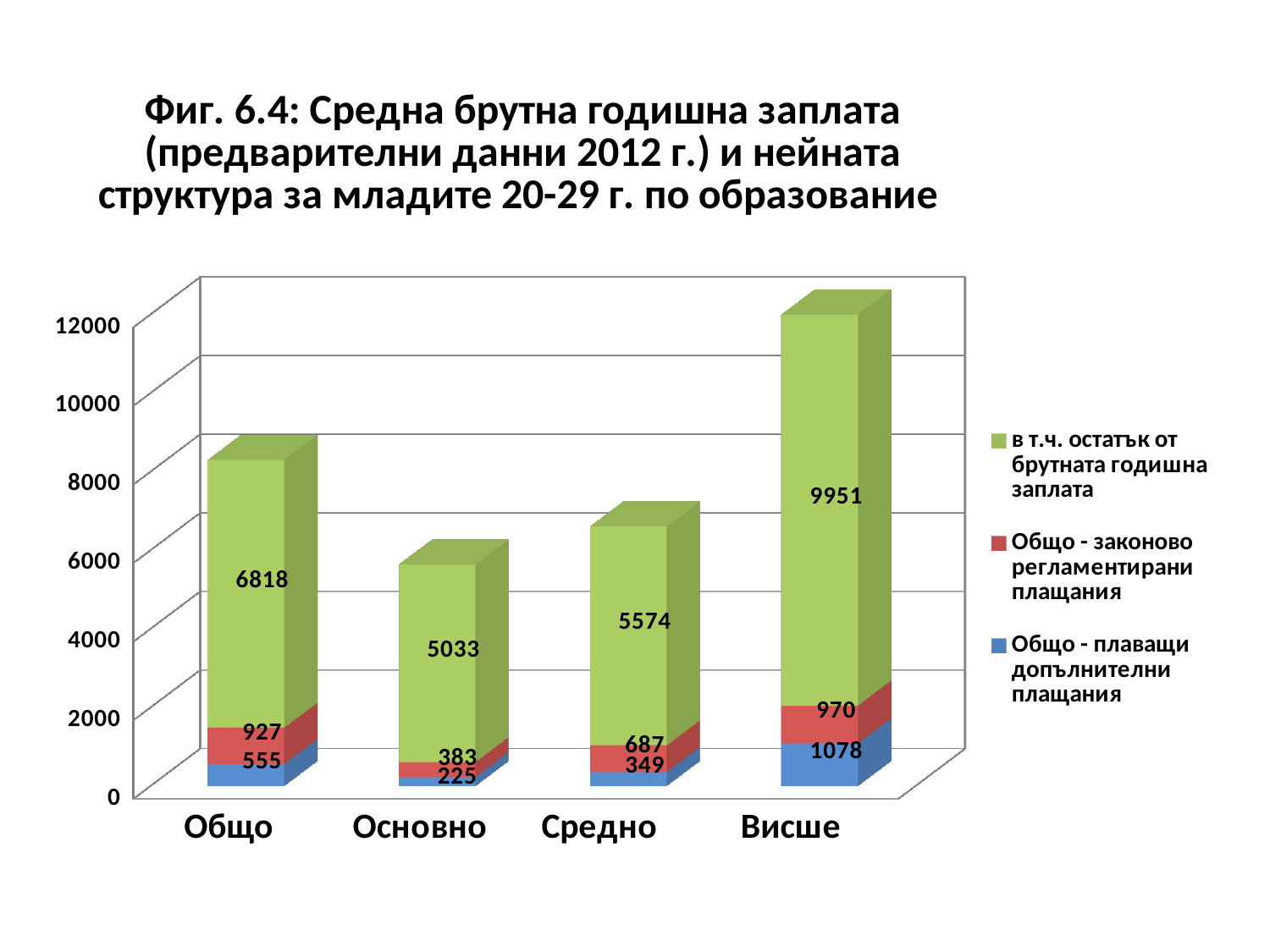
Which category has the lowest value for 'Общо - плаващи допълнителни плащания'? Основно Which category has the highest value for 'в т.ч. остатък от брутната годишна заплата'? Висше What is the difference between the 'в т.ч. остатък от брутната годишна заплата' values for Висше and Общо? 3133 What is the value of 'в т.ч. остатък от брутната годишна заплата' for Висше? 9951 How many series does the legend list? 3 Which is larger: the 'Общо - законово регламентирани плащания' value for Общо or for Висше? Висше What is the value of 'Общо - плаващи допълнителни плащания' for Основно? 225 What is the value of 'Общо - законово регламентирани плащания' for Средно? 687 What is the total of the stacked bar for Общо? 8300 How many categories are shown on the x axis? 4 What is the total of the stacked bar for Основно? 5641 What kind of chart is shown on the slide? Stacked bar chart